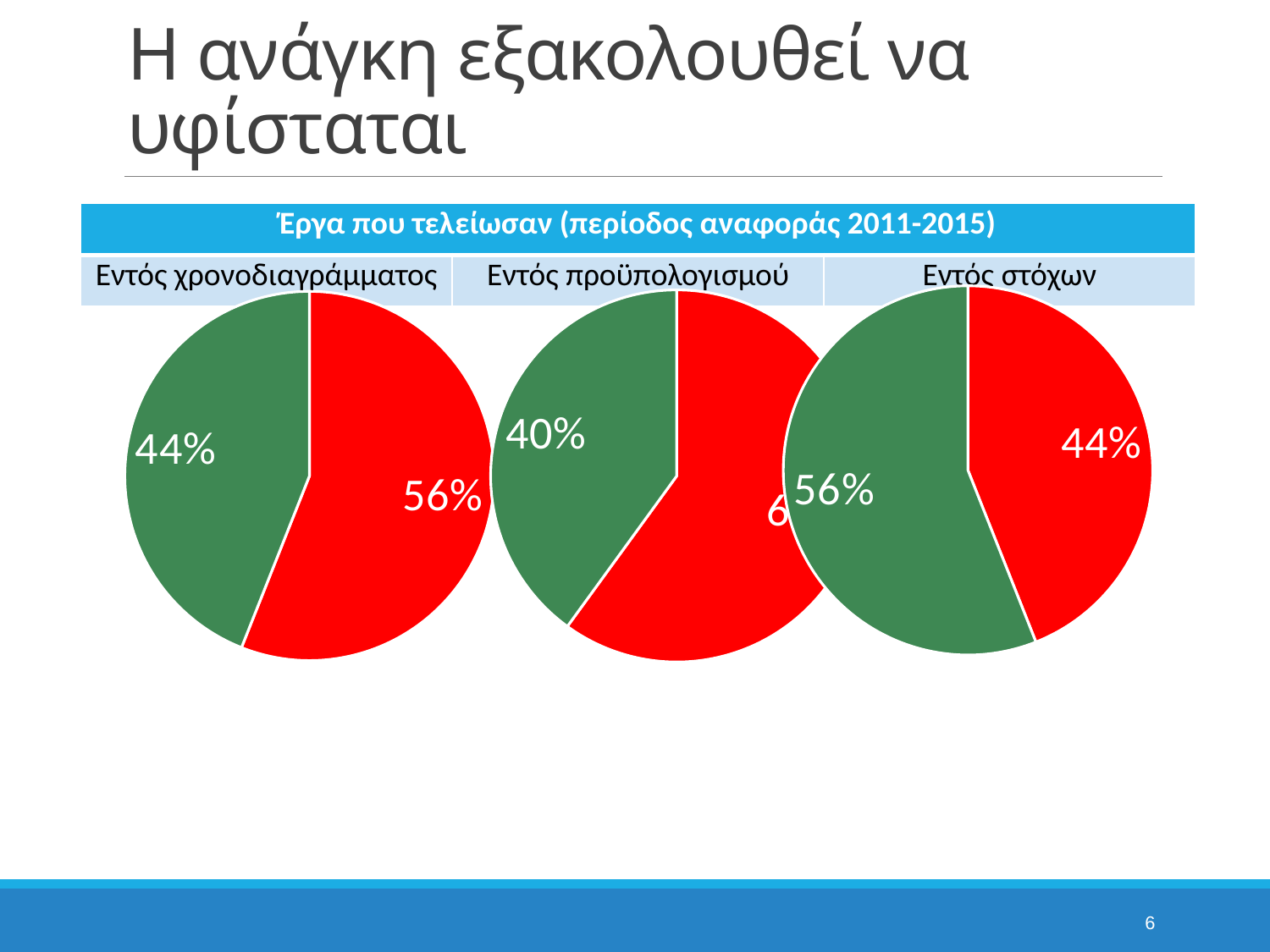
What is the title of the table header above the pie charts? Έργα που τελείωσαν (περίοδος αναφοράς 2011-2015) In the 'Εντός προϋπολογισμού' pie chart, what percentage is shown for the green slice? 40% What kind of charts are shown on the slide? pie charts In the 'Εντός στόχων' pie chart, what percentage is shown for the red slice? 44% In the 'Εντός χρονοδιαγράμματος' pie chart, what percentage is shown for the red slice? 56% In the 'Εντός στόχων' pie chart, what percentage is shown for the green slice? 56% In the 'Εντός χρονοδιαγράμματος' pie chart, what percentage is shown for the green slice? 44% In the 'Εντός προϋπολογισμού' pie chart, which slice is larger, the green or the red? red How many pie charts are shown on the slide? 3 In the 'Εντός χρονοδιαγράμματος' pie chart, which slice is larger, the green or the red? red In the 'Εντός στόχων' pie chart, which slice is larger, the green or the red? green In the 'Εντός χρονοδιαγράμματος' pie chart, what is the difference between the red and green slices? 12%